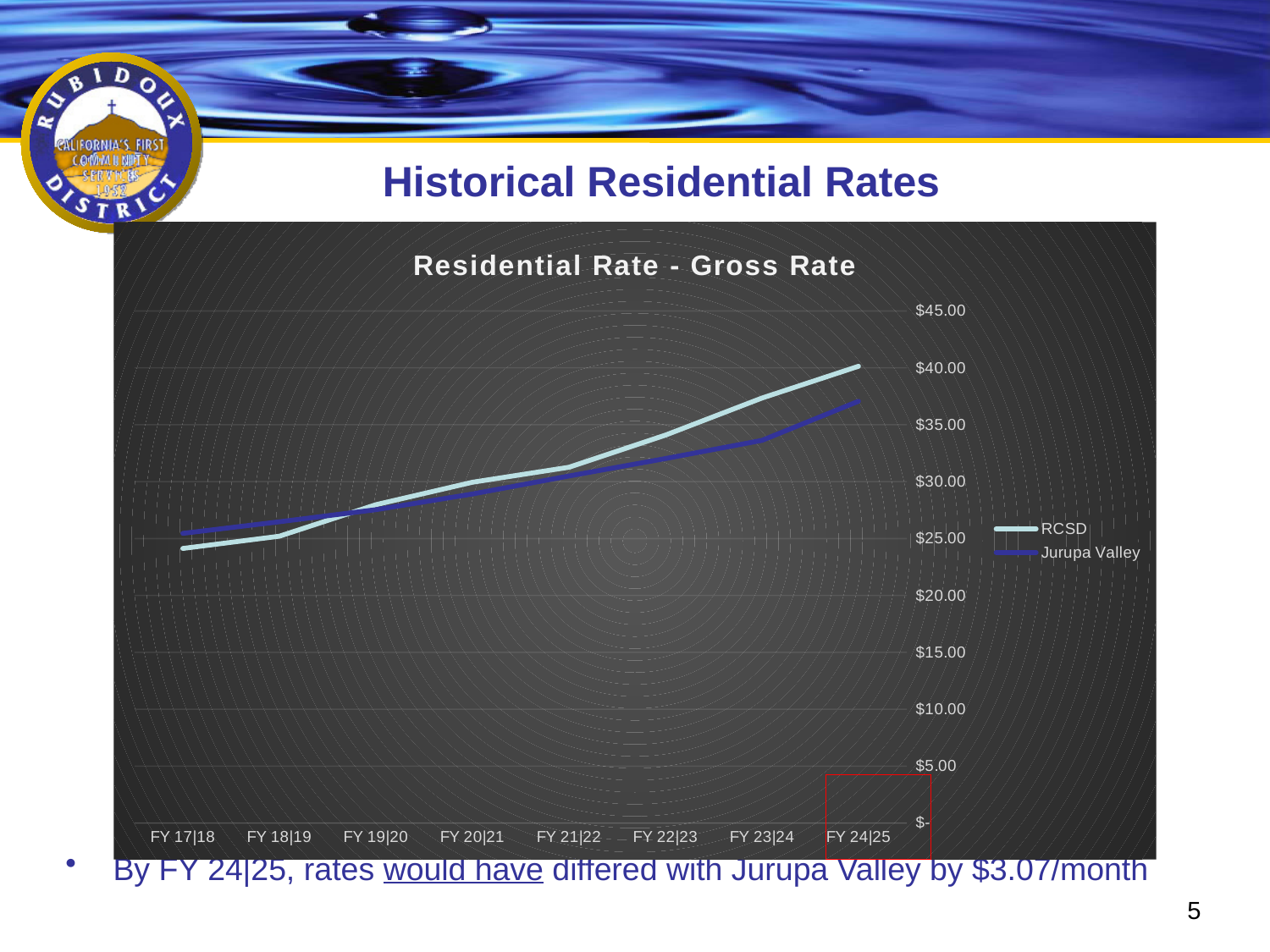
Is the Jurupa Valley value for FY 24|25 greater or less than $30.00? greater In which fiscal year does the RCSD series reach its highest value? FY 24|25 How many fiscal years are shown along the x axis of the chart? 8 Is the RCSD value for FY 24|25 greater or less than $35.00? greater Do the RCSD values rise or fall from FY 17|18 to FY 24|25? rise Is the RCSD value for FY 17|18 greater or less than $30.00? less Which two series are listed in the chart's legend? RCSD and Jurupa Valley What type of chart is shown on the slide? line chart Do the Jurupa Valley values rise or fall across the fiscal years shown? rise How many series does the chart's legend list? 2 At FY 24|25, which series has the higher value, RCSD or Jurupa Valley? RCSD What is the title of the chart? Residential Rate - Gross Rate